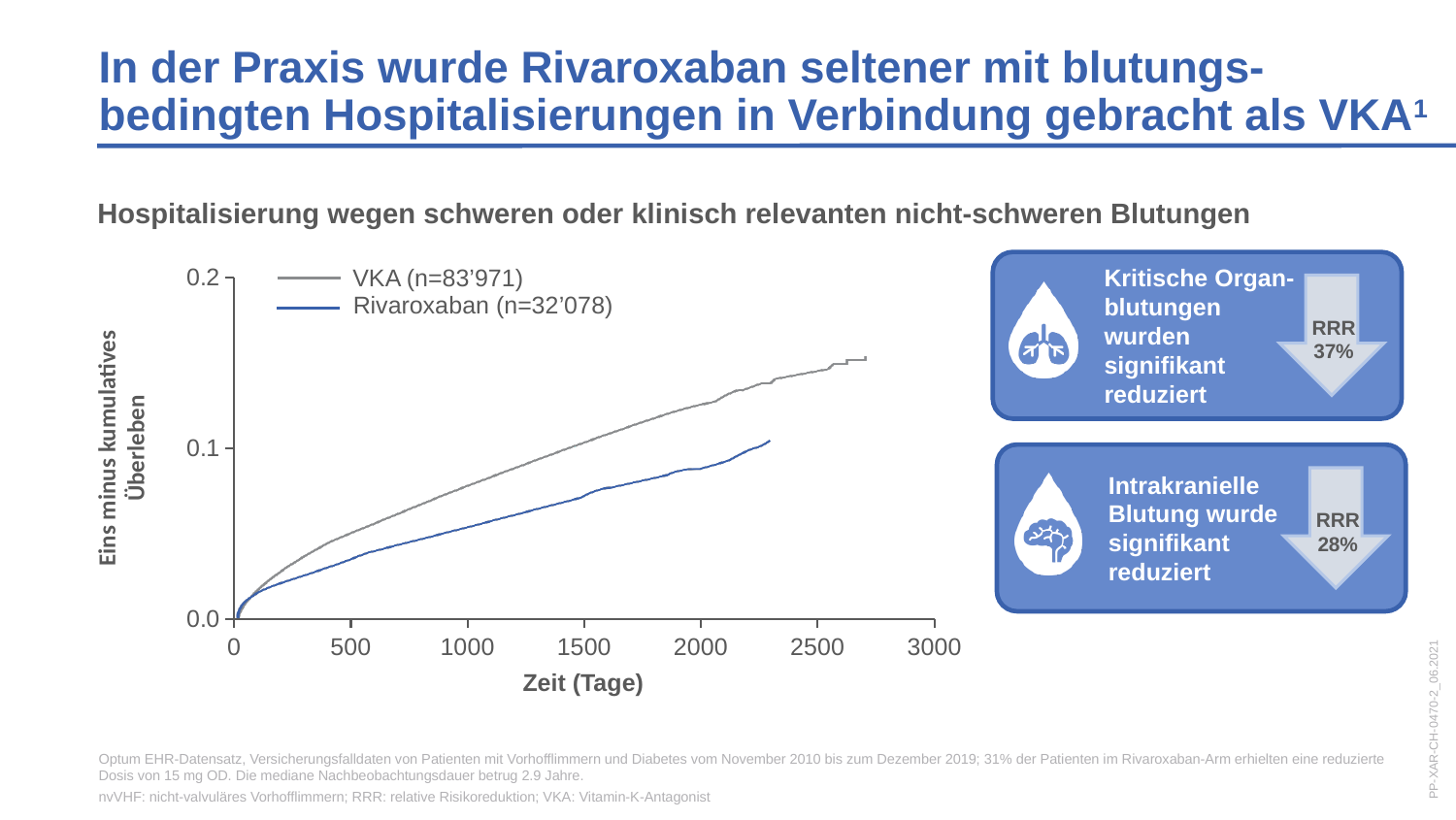
At 1500 days, which series has the higher value, VKA or Rivaroxaban? VKA Do the values of the Rivaroxaban curve rise or fall as time increases along the x axis? rise Do the values of the VKA curve rise or fall as time increases along the x axis? rise Is the value for VKA at 2000 days greater or less than 0.1? greater Which two series are listed in the chart legend? VKA (n=83'971) and Rivaroxaban (n=32'078) Is the value for Rivaroxaban at 2000 days greater or less than 0.1? less At 2000 days, which series has the lower value, VKA or Rivaroxaban? Rivaroxaban Is the highest value reached by the VKA curve greater or less than 0.2? less What is the title of the x axis of the chart? Zeit (Tage) What kind of chart is shown on the slide? line chart How many series does the chart legend list? 2